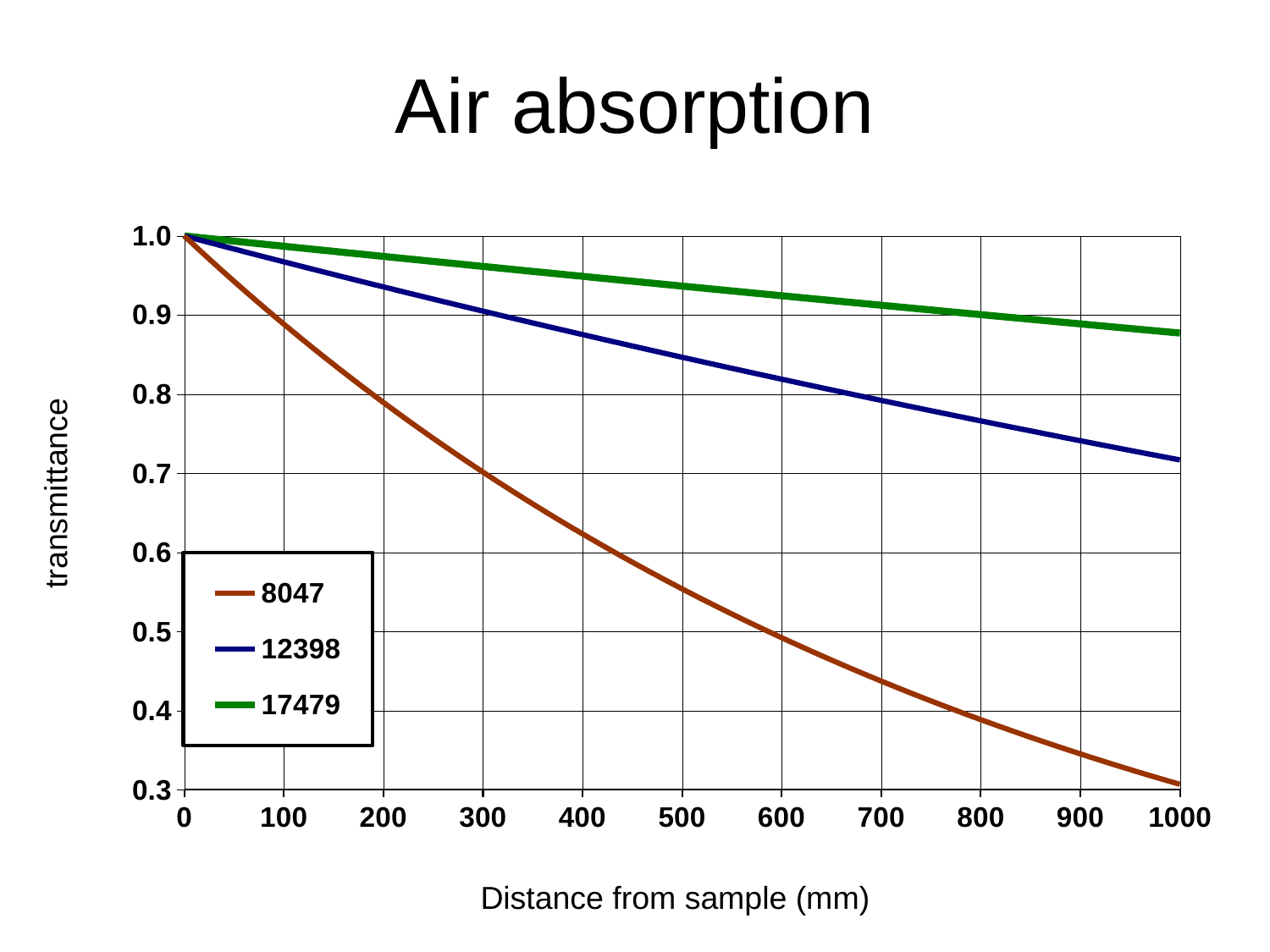
Is the transmittance for series 8047 at 500 mm greater or less than 0.6? less How many series does the legend list? 3 What is the title of the chart? Air absorption Which series has the highest transmittance at 1000 mm? 17479 Which series has the lowest transmittance at 1000 mm? 8047 At 600 mm, which series has the larger transmittance, 12398 or 8047? 12398 Does the transmittance for series 8047 rise or fall as distance from sample increases? fall What kind of chart is shown on the slide? line chart What is the label of the y axis? transmittance Is the transmittance for series 12398 at 1000 mm greater or less than 0.7? greater Is the transmittance for series 17479 at 1000 mm greater or less than 0.9? less